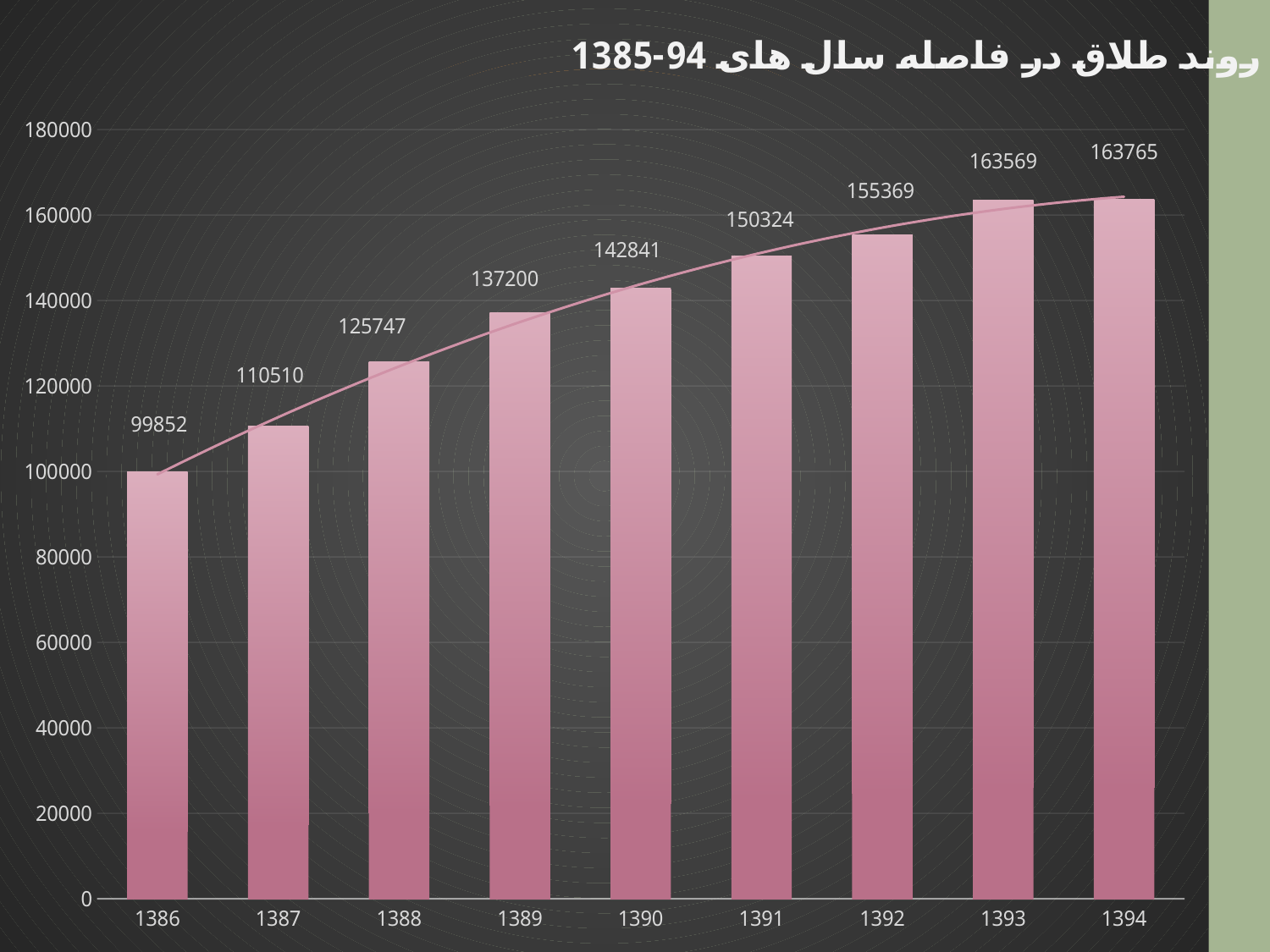
Do the values rise or fall from 1386 to 1394? rise What is the difference between the values for 1394 and 1386? 63913 Which year has the lowest value? 1386 Which year has the highest value? 1394 How many years are shown on the x axis? 9 What is the value for 1386? 99852 Which is larger, the value for 1391 or the value for 1387? 1391 What is the difference between the values for 1389 and 1388? 11453 What is the value for 1393? 163569 What is the value for 1390? 142841 What kind of chart is this? bar chart Is the value for 1392 greater or less than 140000? greater